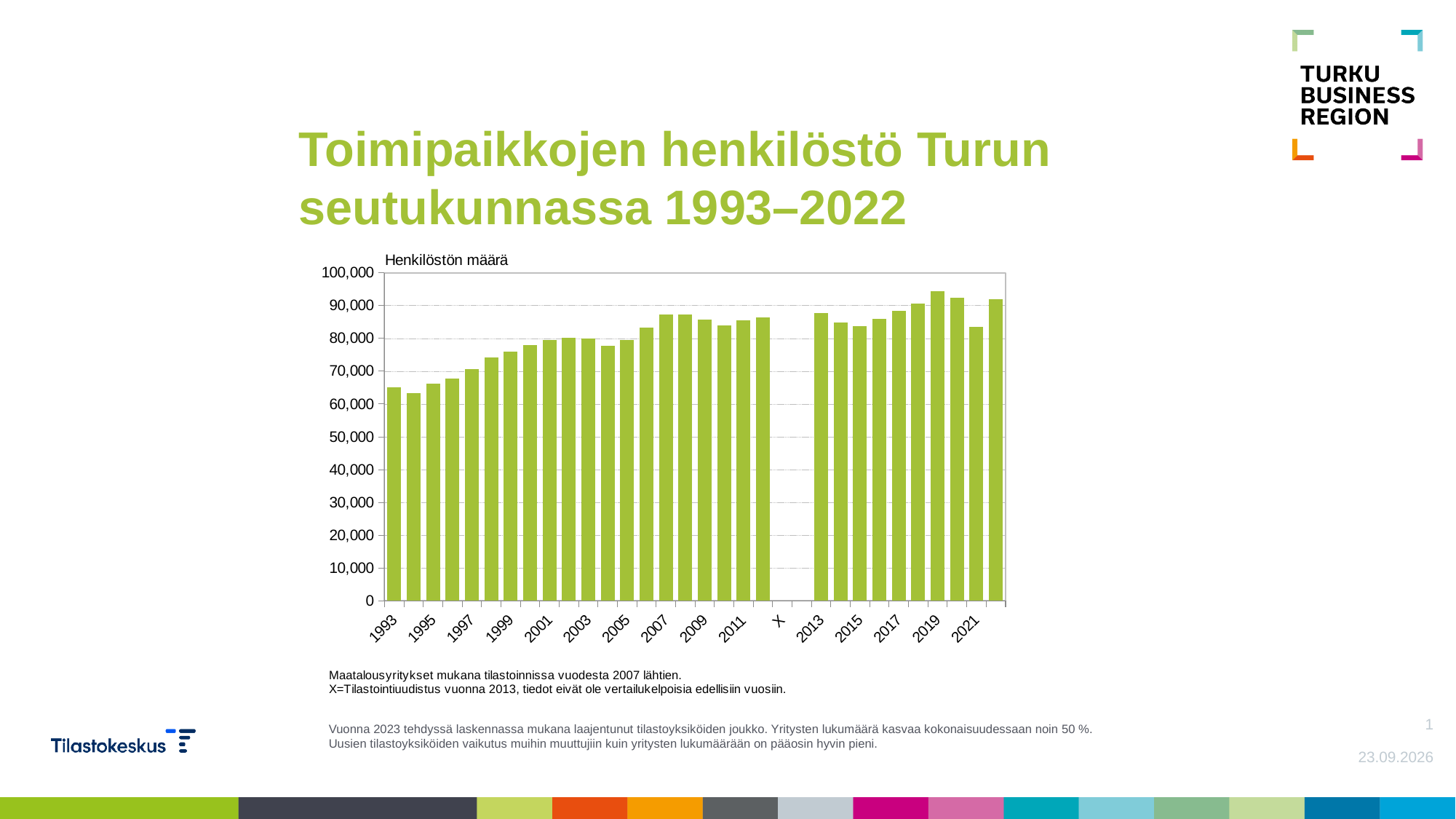
Is the value for 2021 greater or less than 90,000? less Which year has a larger value, 2019 or 2021? 2019 Which year has the highest bar in the chart? 2019 Is the value for 2019 greater or less than 90,000? greater Which year has the lowest bar in the chart? 1994 Is the value for 1993 greater or less than 60,000? greater What is the title of the chart on the slide? Toimipaikkojen henkilöstö Turun seutukunnassa 1993–2022 What label is shown above the vertical axis of the chart? Henkilöstön määrä Do the values generally rise or fall from 1993 to 2003? rise What kind of chart is shown on the slide? bar chart Which year has a larger value, 1993 or 2007? 2007